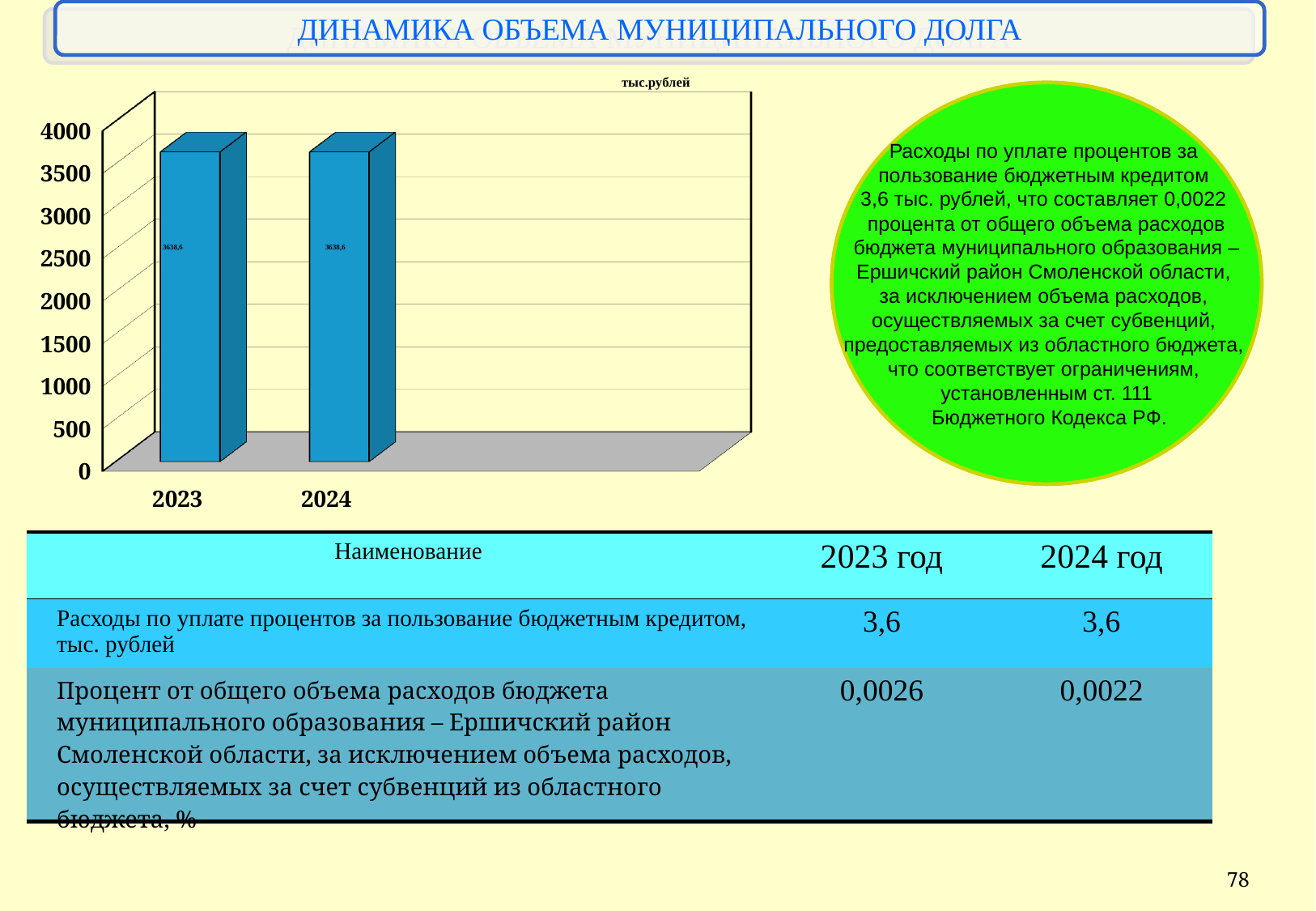
What kind of chart is shown on the slide? bar chart What unit is indicated above the chart? тыс.рублей Is the value for 2023 greater or less than 3500? greater Is the value for 2024 greater or less than 4000? less What is the highest value shown on the vertical axis of the chart? 4000 Do the values rise, fall or stay the same from 2023 to 2024? stay the same What is the value for 2024 on the chart? 3638,6 How many years (categories) are plotted on the chart? 2 What is the value for 2023 on the chart? 3638,6 What is the difference between the values for 2023 and 2024 on the chart? 0